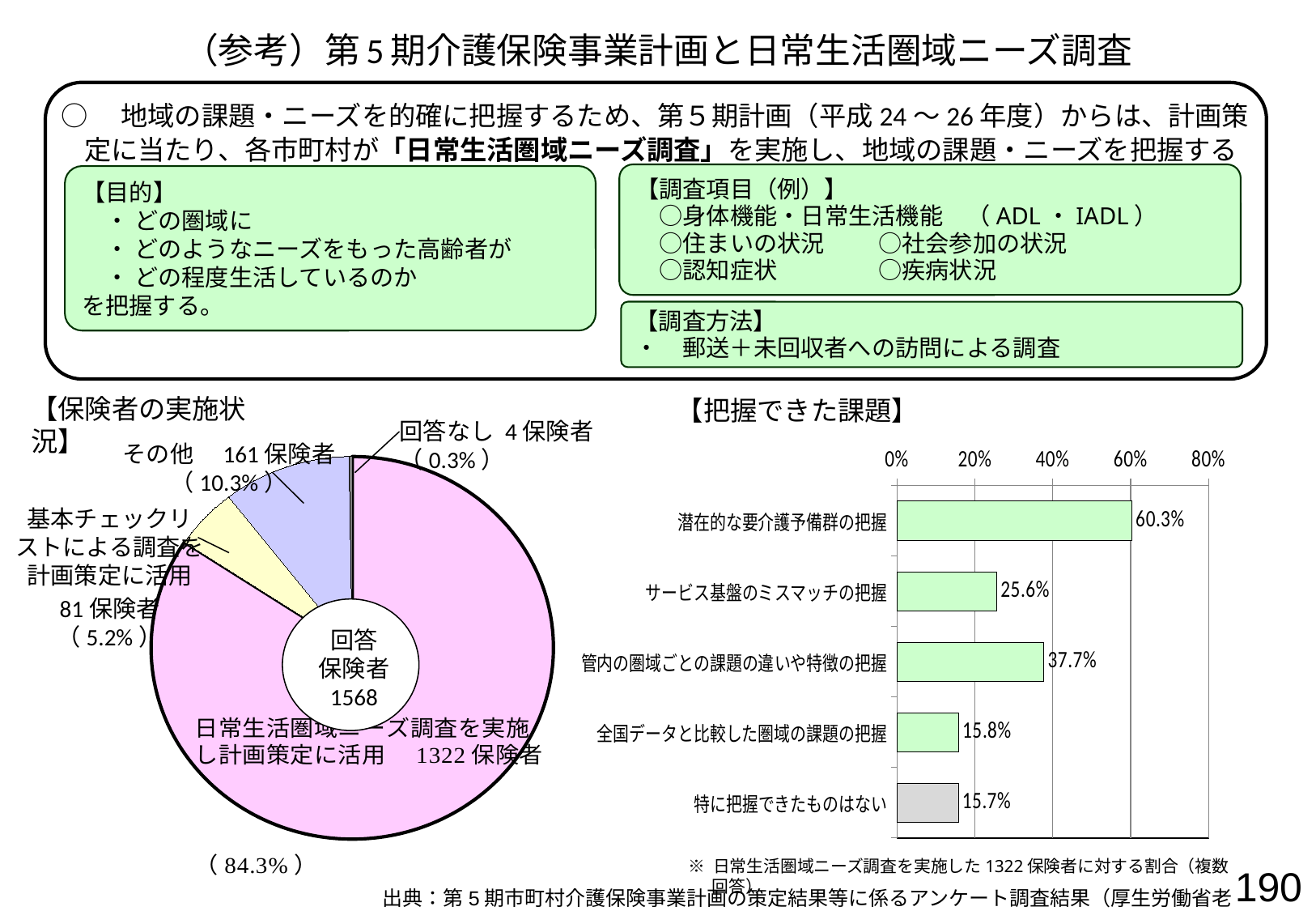
【把握できた課題】の棒グラフには項目がいくつありますか？ 5 【把握できた課題】の棒グラフで、最も値が高い項目はどれですか？ 潜在的な要介護予備群の把握 【把握できた課題】の棒グラフで、「サービス基盤のミスマッチの把握」と「管内の圏域ごとの課題の違いや特徴の把握」ではどちらの値が大きいですか？ 管内の圏域ごとの課題の違いや特徴の把握 【保険者の実施状況】の円グラフで、「その他」の割合は何%ですか？ 10.3% 【把握できた課題】の棒グラフで、「潜在的な要介護予備群の把握」の値は何ですか？ 60.3% 【保険者の実施状況】の円グラフで、「日常生活圏域ニーズ調査を実施し計画策定に活用」の保険者数はいくつですか？ 1322保険者 【把握できた課題】の棒グラフで、「特に把握できたものはない」の値は20%より大きいですか、小さいですか？ 小さい 【把握できた課題】の棒グラフで、「管内の圏域ごとの課題の違いや特徴の把握」と「全国データと比較した圏域の課題の把握」の差は何ポイントですか？ 21.9% 【把握できた課題】の棒グラフで、「サービス基盤のミスマッチの把握」の値は何ですか？ 25.6% 【保険者の実施状況】の円グラフで、最も小さい区分はどれですか？ 回答なし 【把握できた課題】のグラフはどの種類のグラフですか？ 棒グラフ 【保険者の実施状況】の円グラフの中央に示されている回答保険者数はいくつですか？ 1568